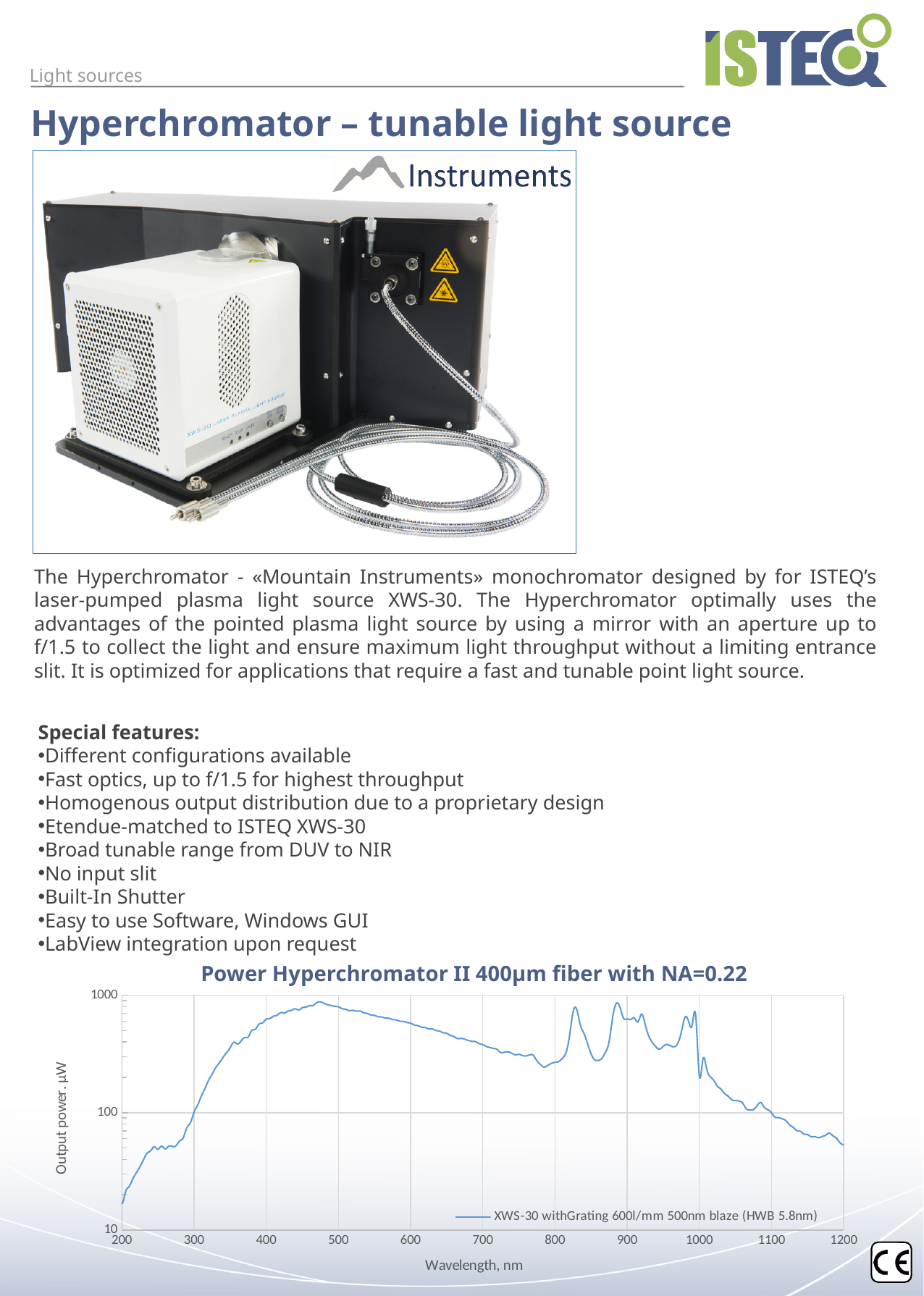
What is the title of the chart? Power Hyperchromator II 400μm fiber with NA=0.22 Does the output power rise or fall as the wavelength increases from 200 nm to 500 nm? rise What kind of chart is shown on the slide? line chart Is the output power at 500 nm larger or smaller than the output power at 1200 nm? larger Is the output power at 400 nm greater or less than 100 μW? greater What is the label of the chart's x axis? Wavelength, nm How many series does the chart's legend list? 1 Is the output power at 500 nm greater or less than 1000 μW? less Is the output power at 200 nm greater or less than 100 μW? less Does the output power generally rise or fall as the wavelength increases from 1000 nm to 1200 nm? fall